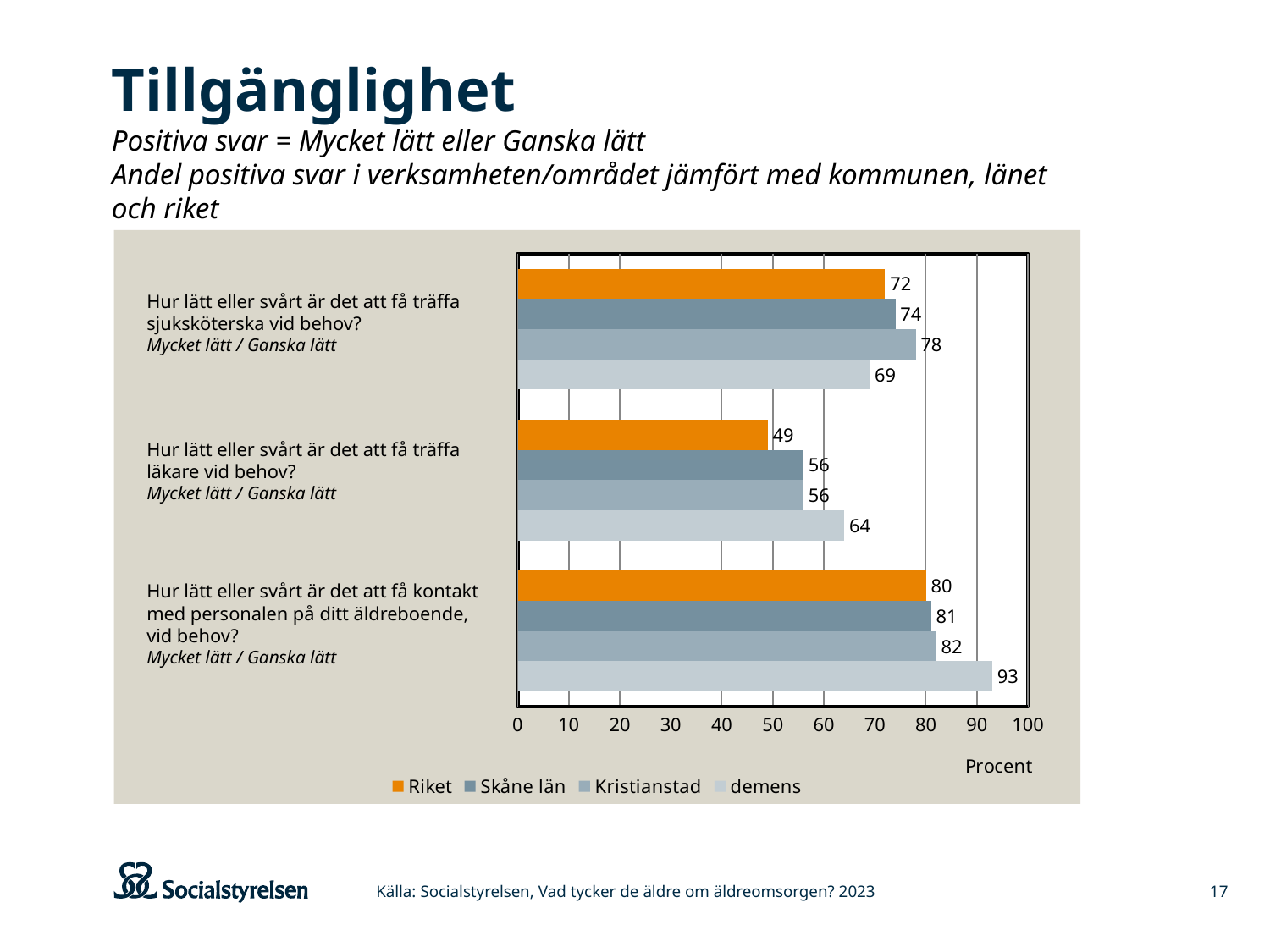
How many series does the legend list? 4 On the question about getting to meet a nurse when needed, which is larger: the value for Kristianstad or the value for demens? Kristianstad What label is shown on the horizontal axis of the chart? Procent How many question categories are plotted on the chart? 3 Which series has the highest value on the question about getting in contact with staff at the care home? demens Which series has the lowest value on the question about getting to meet a doctor when needed? Riket What is the value for demens on the question about getting to meet a doctor (läkare) when needed? 64 What is the value for Riket on the question about getting to meet a nurse (sjuksköterska) when needed? 72 What is the difference between the Kristianstad value and the Riket value on the question about getting to meet a nurse when needed? 6 What is the value for Kristianstad on the question about getting in contact with staff at the care home (kontakt med personalen)? 82 What is the difference between the demens value and the Riket value on the question about getting in contact with staff at the care home? 13 What kind of chart is shown on the slide? Bar chart